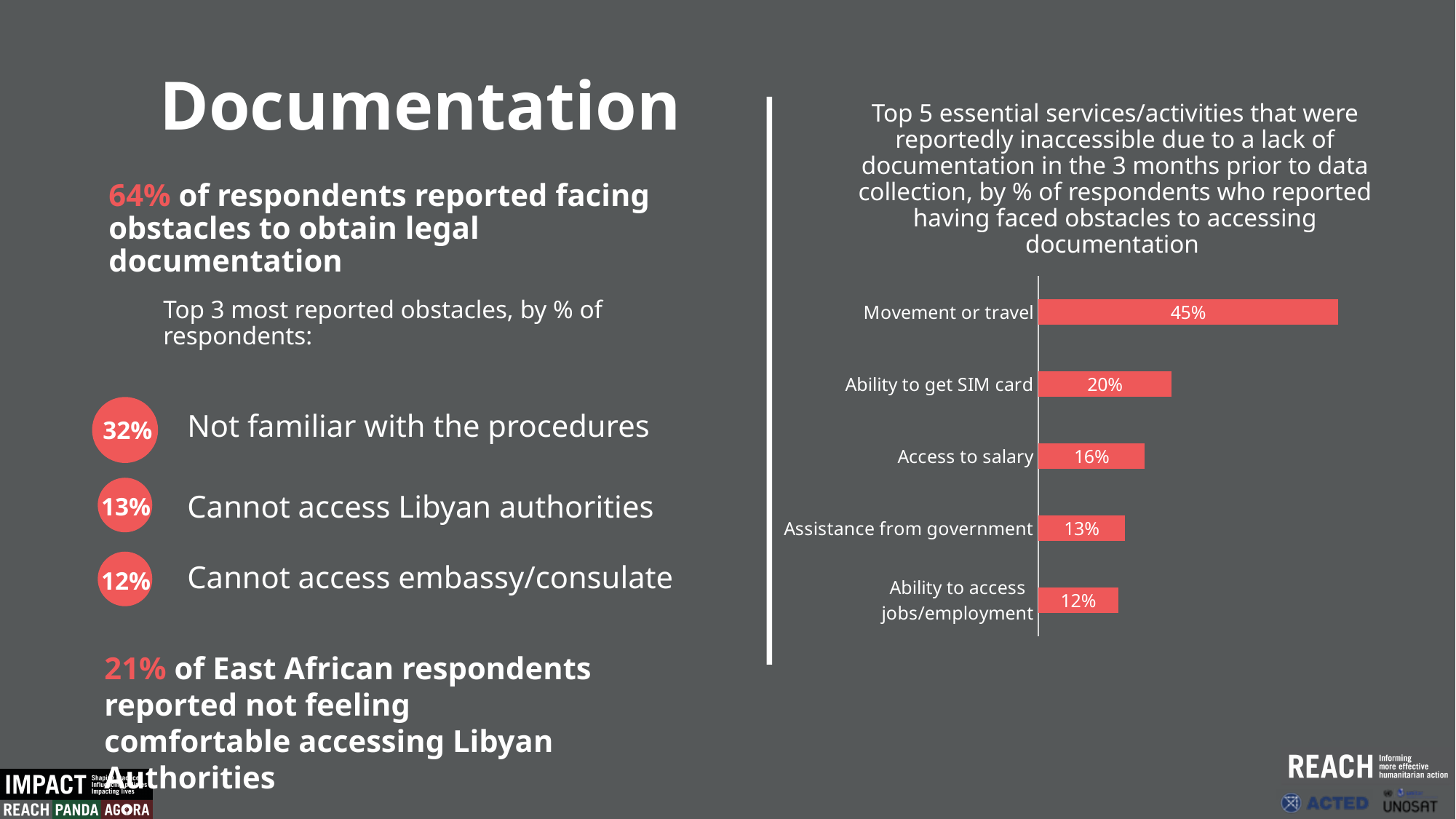
Which is larger in the chart: 'Access to salary' or 'Assistance from government'? Access to salary What is the difference in percentage points between 'Movement or travel' and 'Ability to get SIM card'? 25 Which service/activity has the highest percentage in the bar chart? Movement or travel Which service/activity has the lowest percentage in the bar chart? Ability to access jobs/employment What colour are the bars in the chart? Red How many services/activities are shown in the bar chart? 5 What percentage is shown for 'Access to salary'? 16% What percentage of respondents reported that movement or travel was inaccessible due to a lack of documentation? 45% What percentage is shown for 'Ability to access jobs/employment'? 12% What is the value for 'Assistance from government' in the chart? 13% What is the value shown for 'Ability to get SIM card' in the bar chart? 20% What type of chart is used to show the top 5 inaccessible services/activities? Bar chart